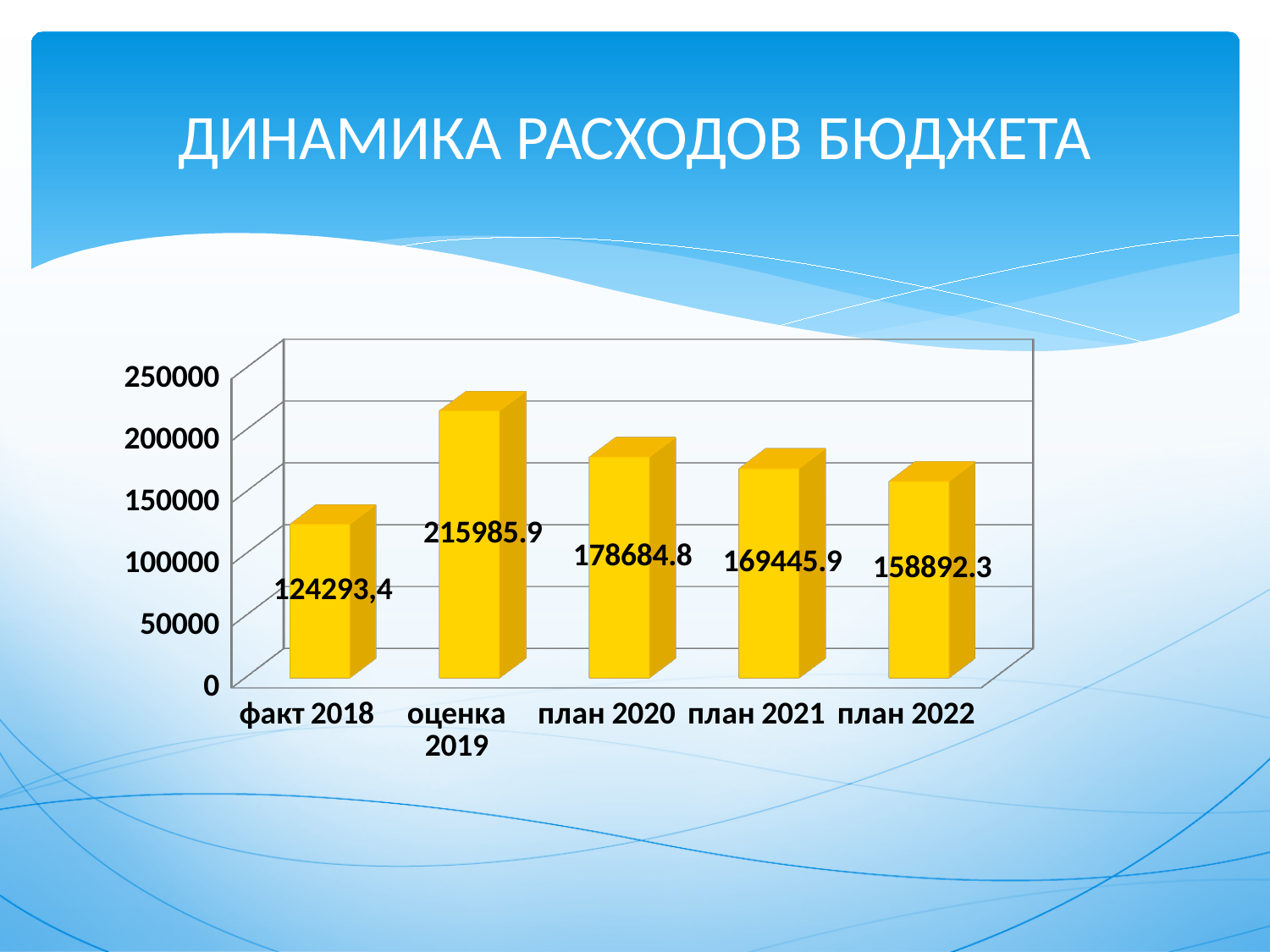
What is the value for факт 2018? 124293,4 What is the difference between the values for план 2021 and план 2022? 10553.6 Do the values rise or fall from план 2020 to план 2022? fall Is the value for факт 2018 greater or less than 150000? less Which is larger, the value for план 2020 or the value for план 2021? план 2020 How many categories are shown on the x axis? 5 Which category has the highest value? оценка 2019 What is the value for план 2022? 158892.3 What is the difference between the values for оценка 2019 and план 2020? 37301.1 What is the value for план 2021? 169445.9 What is the value for оценка 2019? 215985.9 Which category has the lowest value? факт 2018